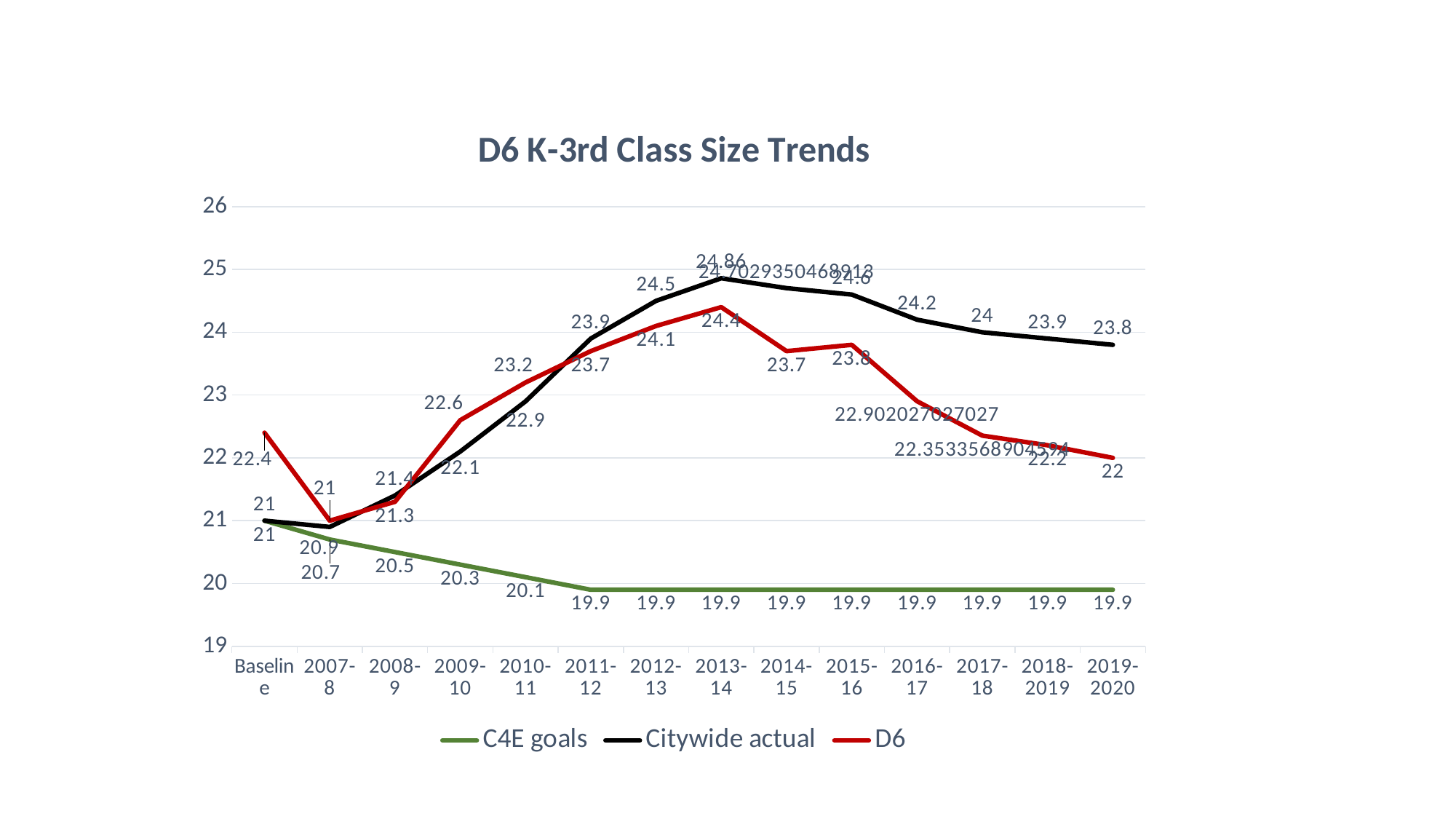
How many categories are shown along the x axis? 14 In 2012-13, which is larger: Citywide actual or D6? Citywide actual What is the difference between Citywide actual and D6 in 2019-2020? 1.8 Is the D6 value for 2016-17 greater or less than 22? greater In which year is the D6 series at its lowest value? 2007-8 In which year does the D6 series reach its highest value? 2013-14 What is the C4E goals value for 2019-2020? 19.9 What type of chart is shown on the slide? Line chart What is the D6 value at Baseline? 22.4 What is the Citywide actual value for 2013-14? 24.86 What is the title of the chart? D6 K-3rd Class Size Trends How many series does the legend list? 3